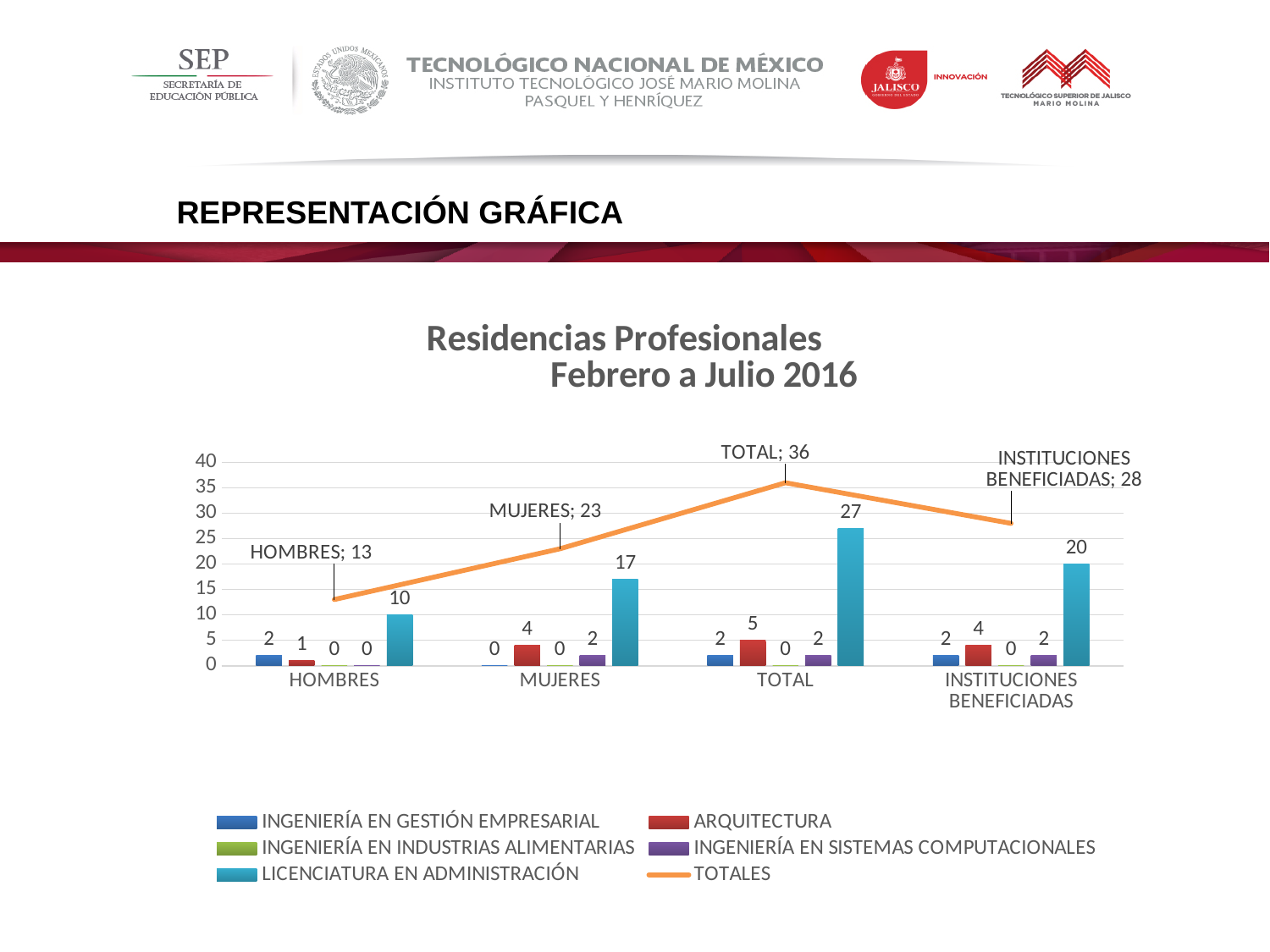
What kind of chart is this? Combined bar and line chart What is the value of LICENCIATURA EN ADMINISTRACIÓN for MUJERES? 17 What is the value of the TOTALES line for TOTAL? 36 Which category has the lowest value for LICENCIATURA EN ADMINISTRACIÓN? HOMBRES How many series does the legend list? 6 What is the difference between the TOTALES values for MUJERES and HOMBRES? 10 Which is larger: LICENCIATURA EN ADMINISTRACIÓN for TOTAL or for INSTITUCIONES BENEFICIADAS? TOTAL How many categories are shown on the x axis? 4 What is the title of the chart? Residencias Profesionales Febrero a Julio 2016 What is the value of the TOTALES line for HOMBRES? 13 Which category has the highest value on the TOTALES line? TOTAL What is the value of ARQUITECTURA for TOTAL? 5